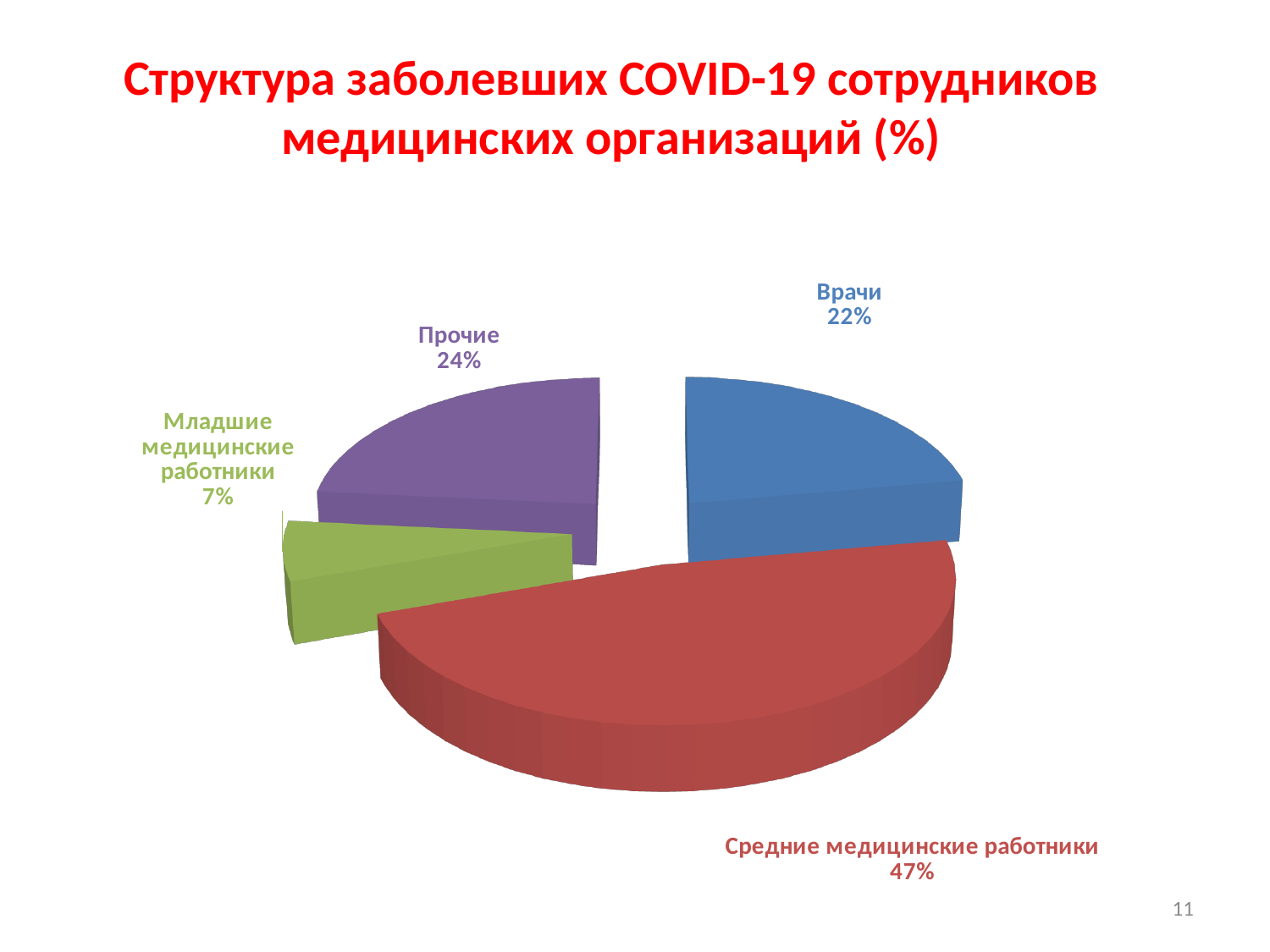
Which is larger, the share for Прочие or the share for Врачи? Прочие What percentage of the pie is labelled Врачи? 22% What percentage of the pie is labelled Средние медицинские работники? 47% What type of chart is shown on the slide? pie chart Which category has the smallest share of the pie? Младшие медицинские работники What is the difference in percentage points between Прочие and Младшие медицинские работники? 17 How many slices does the pie chart have? 4 What percentage of the pie is labelled Младшие медицинские работники? 7% What colour is the slice for Средние медицинские работники? red What is the difference in percentage points between Средние медицинские работники and Врачи? 25 Which category has the largest share of the pie? Средние медицинские работники What percentage of the pie is labelled Прочие? 24%